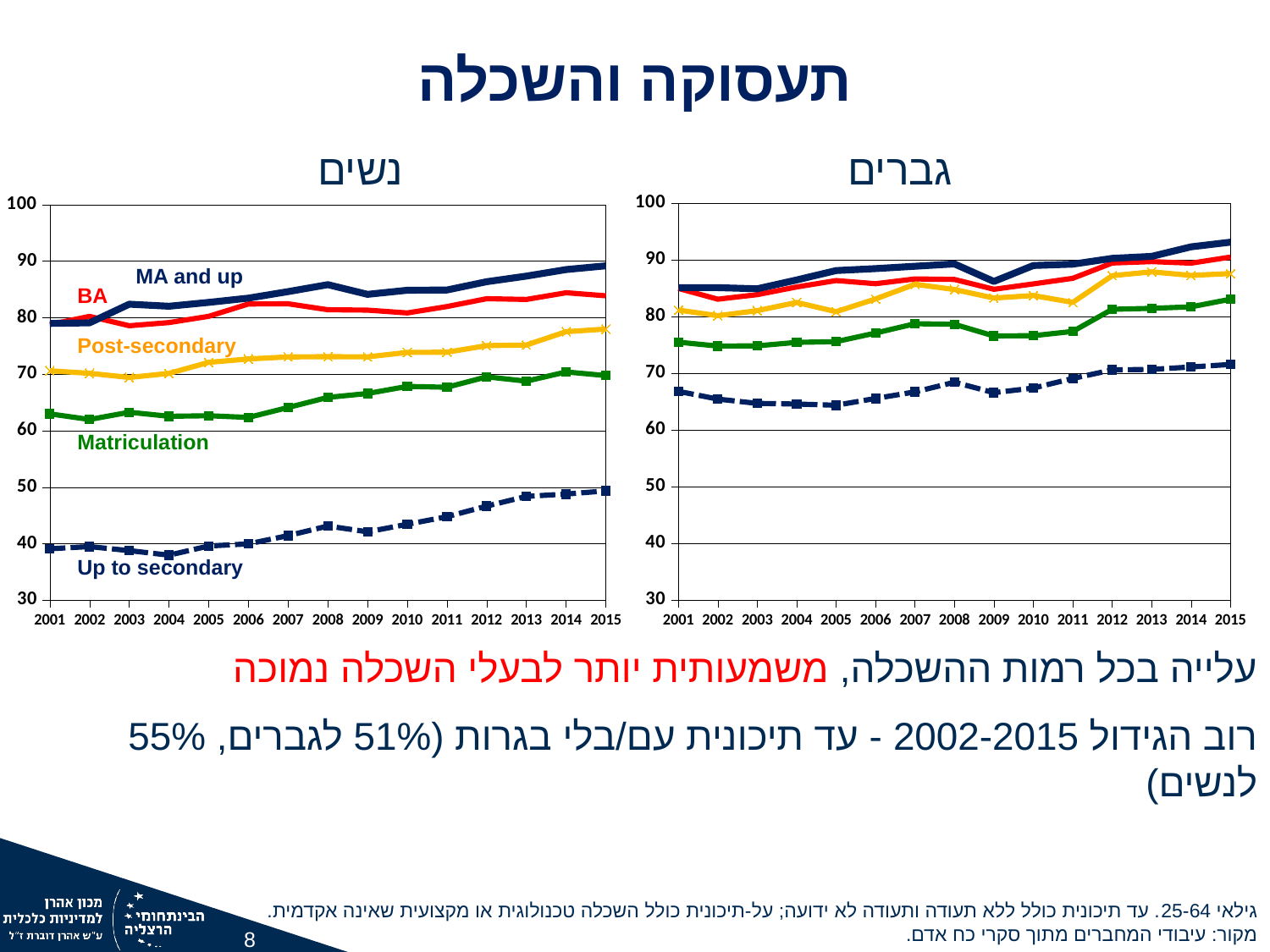
On the left chart titled נשים, which series has the lowest values throughout the period? Up to secondary On the left chart titled נשים, is the value for Matriculation in 2015 greater or less than 60? greater How many series are labelled on the left chart titled נשים? 5 On the left chart titled נשים, which series has the highest values in 2015? MA and up On the right chart titled גברים, is the value of the dashed Up to secondary line in 2015 greater or less than 70? greater On the left chart titled נשים, does the Up to secondary series rise or fall from 2004 to 2015? rise What kind of chart is the left chart titled נשים? line chart What is the first year shown on the x axis of the left chart titled נשים? 2001 How many years are plotted along the x axis of the right chart titled גברים? 15 Which is larger in 2015: the Up to secondary value on the left chart (נשים) or the Up to secondary value on the right chart (גברים)? גברים (right chart) On the left chart titled נשים, is the value for Up to secondary in 2001 greater or less than 40? less